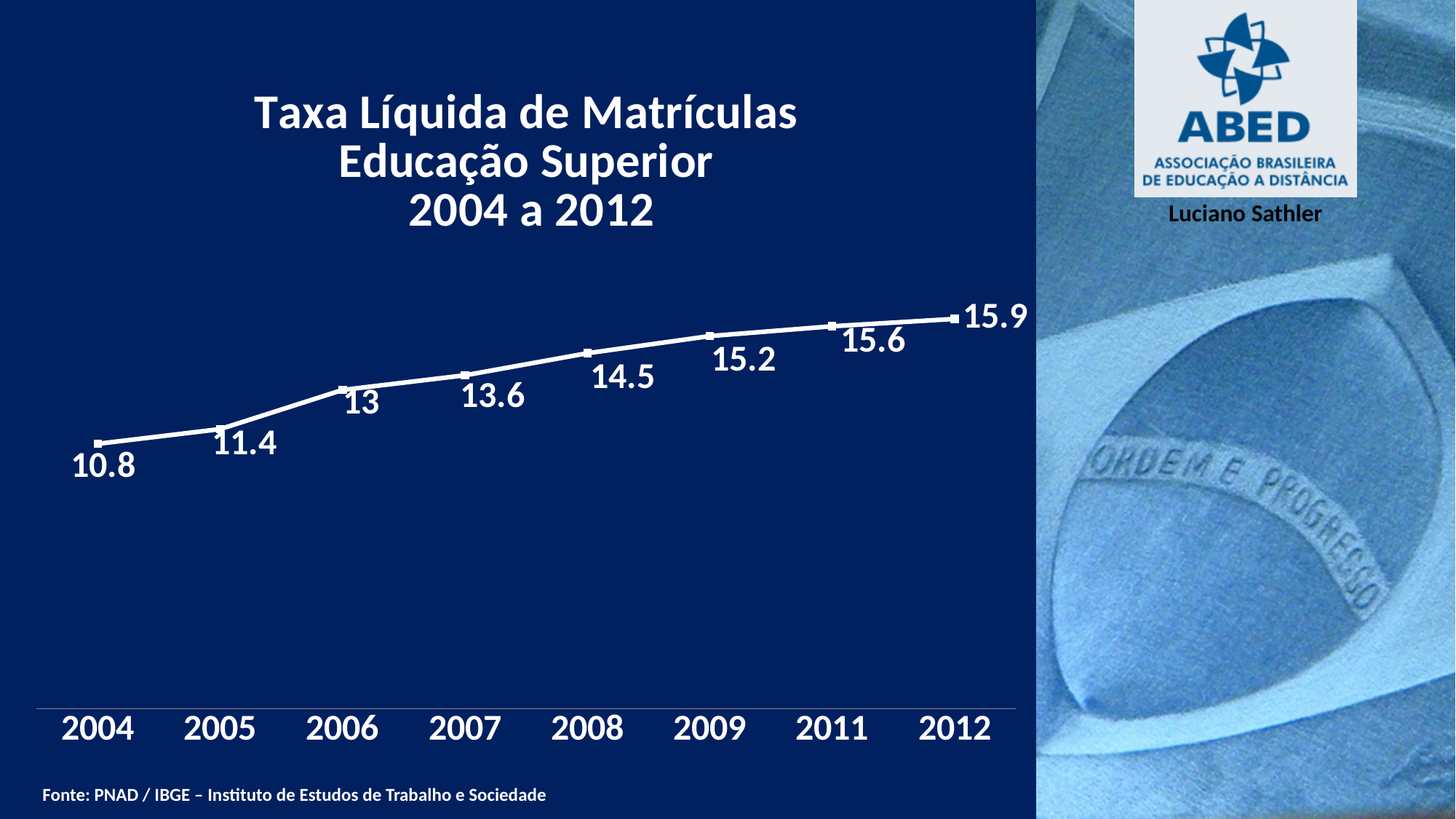
What is the value for 2004? 10.8 What is the difference between the values for 2012 and 2004? 5.1 What is the title of the chart? Taxa Líquida de Matrículas Educação Superior 2004 a 2012 What is the value for 2008? 14.5 Do the values rise or fall from 2004 to 2012? rise What kind of chart is shown? line chart What is the value for 2012? 15.9 Which year has the highest value? 2012 Which year has the lowest value? 2004 Which is larger, the value for 2009 or the value for 2006? 2009 How many data points are plotted on the chart? 8 What is the difference between the values for 2007 and 2006? 0.6